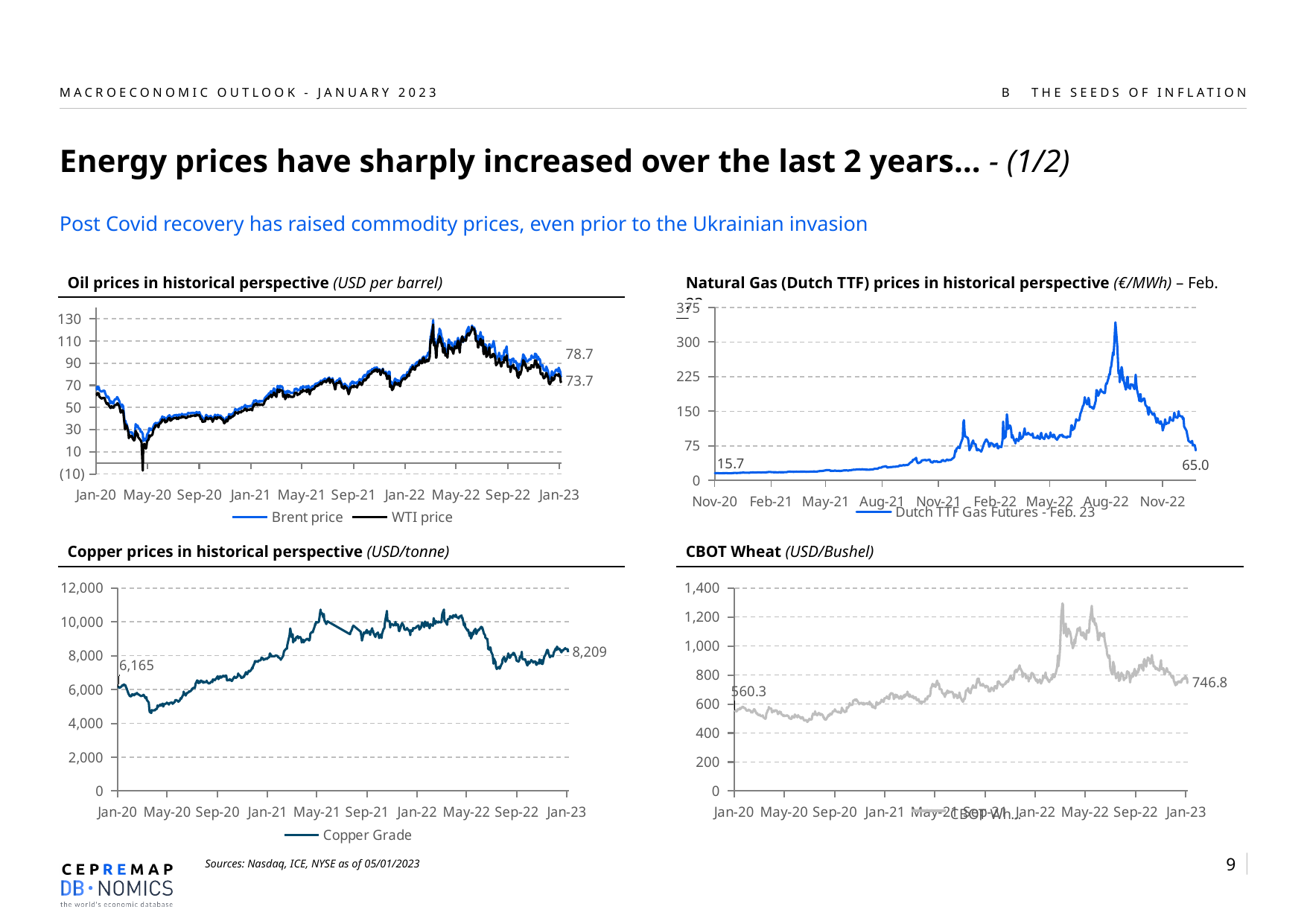
In the 'CBOT Wheat' chart, what is the last labelled value at the end of the series? 746.8 In the 'Oil prices in historical perspective' chart, what is the latest labelled value for the WTI price? 73.7 In the 'Natural Gas (Dutch TTF) prices in historical perspective' chart, what is the first labelled value at the start of the series? 15.7 In the 'Natural Gas (Dutch TTF) prices in historical perspective' chart, what is the last labelled value at the end of the series? 65.0 In the 'Oil prices in historical perspective' chart, what is the difference between the latest labelled Brent price and WTI price? 5.0 In the 'Natural Gas (Dutch TTF) prices in historical perspective' chart, is the peak value around Aug-22 greater or less than 300? greater In the 'Copper prices in historical perspective' chart, what is the difference between the last labelled value (8,209) and the first labelled value (6,165)? 2,044 How many series does the legend of the 'Oil prices in historical perspective' chart list? 2 What series name does the legend of the 'Copper prices in historical perspective' chart show? Copper Grade What kind of chart is the 'Natural Gas (Dutch TTF) prices in historical perspective' chart? Line chart In the 'CBOT Wheat' chart, is the peak value around May-22 greater or less than 1,200? greater In the 'Oil prices in historical perspective' chart, what is the latest labelled value for the Brent price? 78.7